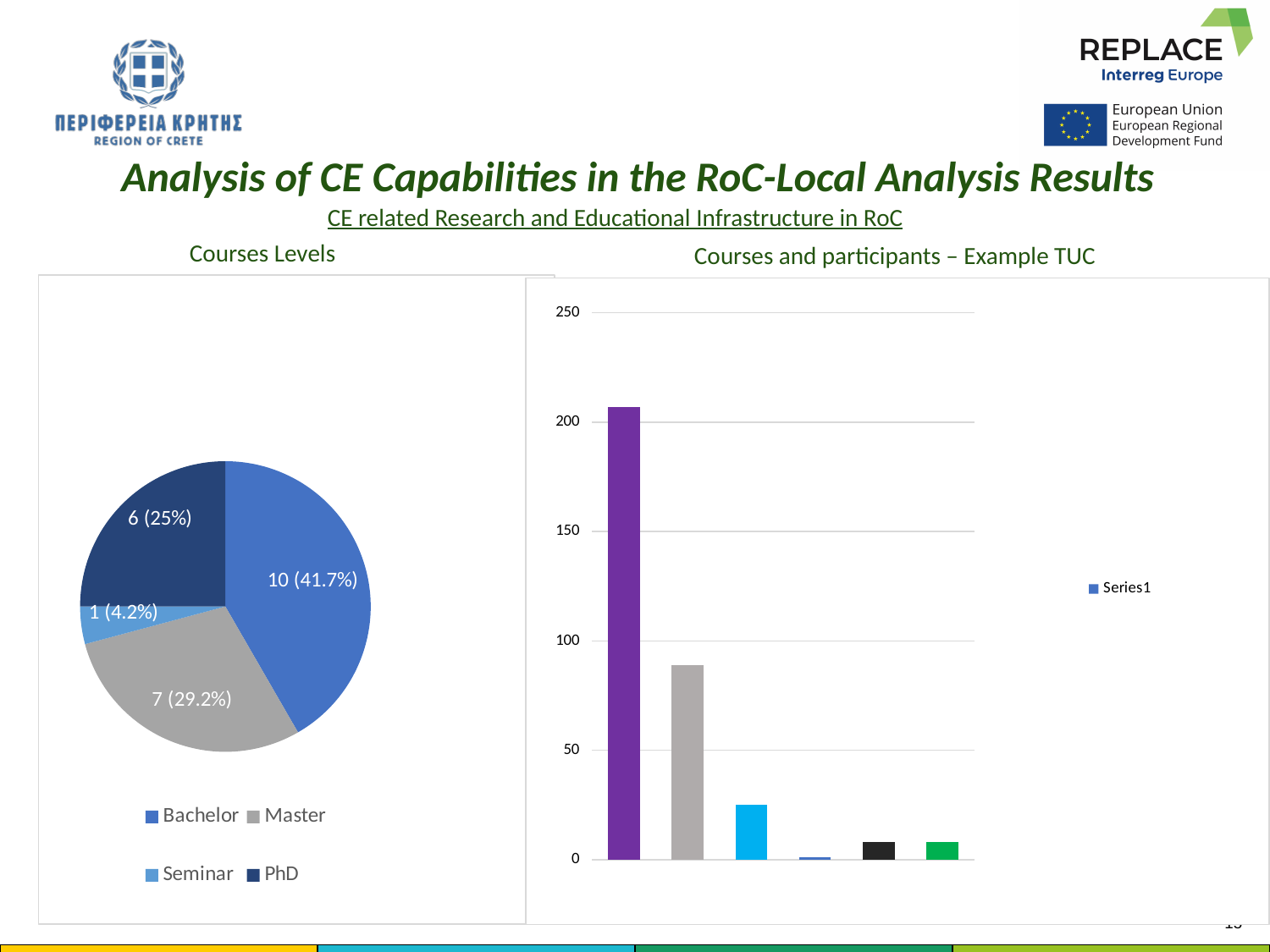
How many bars does the Courses and participants – Example TUC chart show? 6 In the Courses Levels pie chart, which course level has the largest slice? Bachelor In the Courses Levels pie chart, what share of the pie does the PhD slice represent? 25% In the Courses Levels pie chart, how many courses are at Bachelor level? 10 In the Courses Levels pie chart, which has more courses, PhD or Seminar? PhD In the Courses Levels pie chart, what is the difference between the number of Bachelor courses and the number of Master courses? 3 In the Courses Levels pie chart, what share of the pie does the Master slice represent? 29.2% In the Courses and participants – Example TUC chart, is the value of the first (purple) bar greater or less than 200? greater In the Courses and participants – Example TUC chart, is the value of the second (grey) bar greater or less than 100? less In the Courses Levels pie chart, which course level has the smallest slice? Seminar What kind of chart is the Courses Levels chart? Pie chart How many categories does the Courses Levels pie chart show? 4